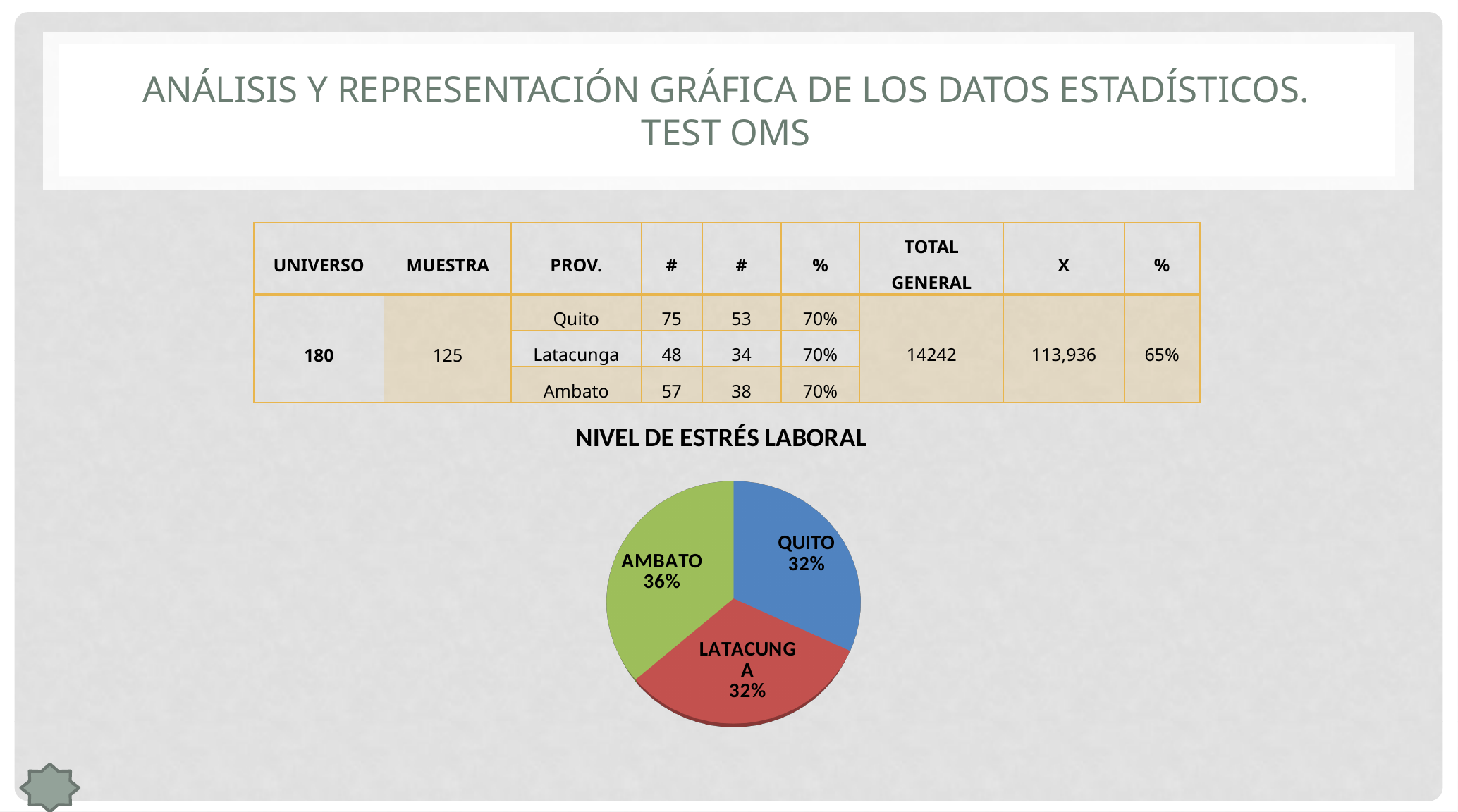
What share of the pie does LATACUNGA represent? 32% What type of chart is shown under the heading "NIVEL DE ESTRÉS LABORAL"? pie chart What colour is the AMBATO slice in the pie chart? green Do the QUITO and LATACUNGA slices show the same percentage? yes What percentage does the QUITO slice show in the pie chart? 32% How many slices does the pie chart have? 3 Which slice of the pie chart is the largest? AMBATO Which is larger in the pie chart, AMBATO or QUITO? AMBATO What percentage does the LATACUNGA slice show in the pie chart? 32% What percentage does the AMBATO slice show in the pie chart? 36% What is the difference in percentage points between the AMBATO and LATACUNGA slices? 4 What is the title of the pie chart? NIVEL DE ESTRÉS LABORAL